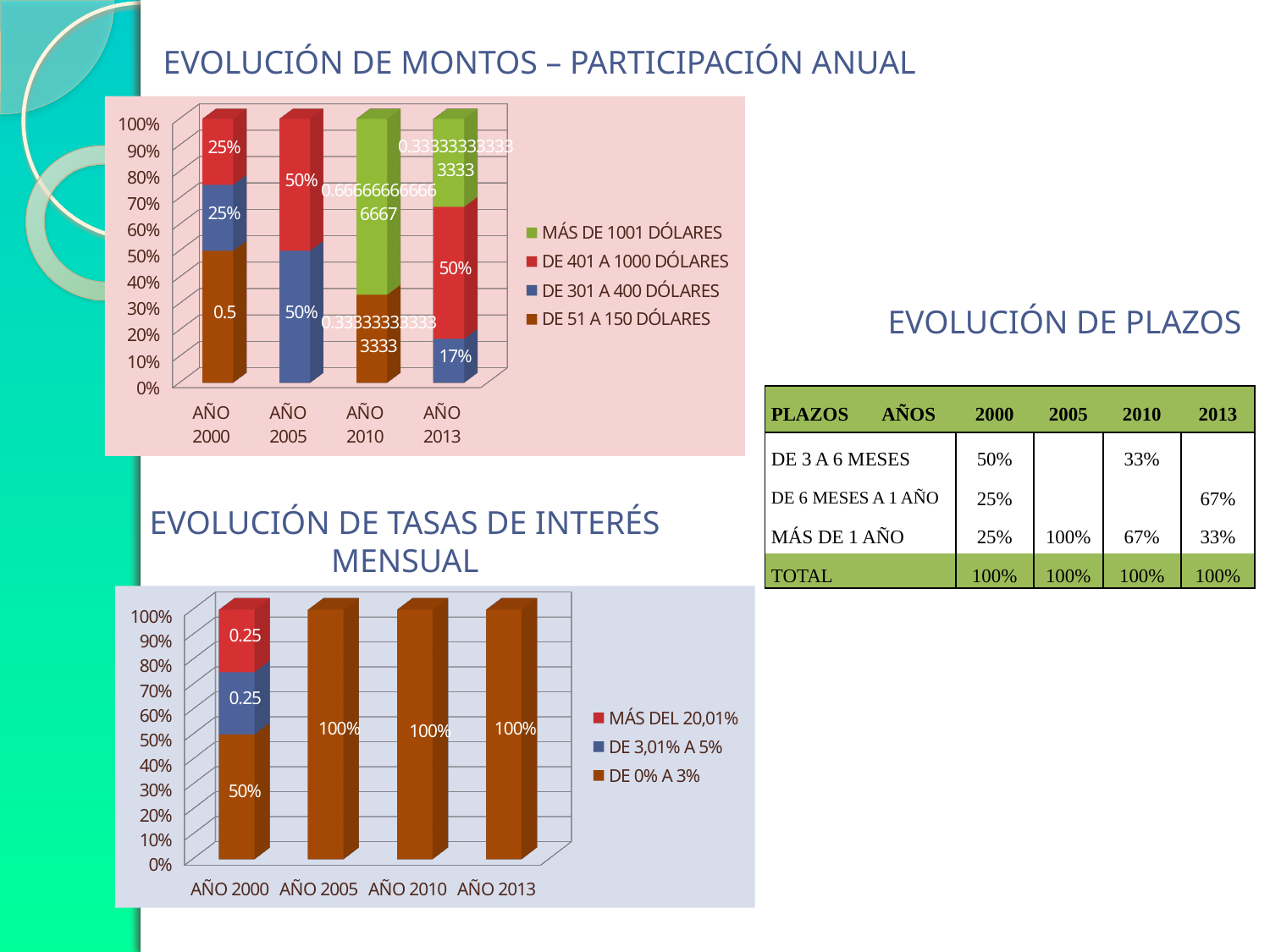
In the 'EVOLUCIÓN DE MONTOS – PARTICIPACIÓN ANUAL' chart, how many years are shown on the x axis? 4 In the 'EVOLUCIÓN DE MONTOS – PARTICIPACIÓN ANUAL' chart, what is the value for DE 301 A 400 DÓLARES in AÑO 2013? 17% In the 'EVOLUCIÓN DE MONTOS – PARTICIPACIÓN ANUAL' chart, what is the value for DE 401 A 1000 DÓLARES in AÑO 2013? 50% In the 'EVOLUCIÓN DE TASAS DE INTERÉS MENSUAL' chart, what is the value for DE 0% A 3% in AÑO 2000? 50% In the 'EVOLUCIÓN DE MONTOS – PARTICIPACIÓN ANUAL' chart, which is larger in AÑO 2013: DE 401 A 1000 DÓLARES or DE 301 A 400 DÓLARES? DE 401 A 1000 DÓLARES In the 'EVOLUCIÓN DE MONTOS – PARTICIPACIÓN ANUAL' chart, what is the value labelled on the DE 51 A 150 DÓLARES segment for AÑO 2000? 0.5 In the 'EVOLUCIÓN DE MONTOS – PARTICIPACIÓN ANUAL' chart, what is the value for DE 301 A 400 DÓLARES in AÑO 2005? 50% In the 'EVOLUCIÓN DE TASAS DE INTERÉS MENSUAL' chart, what is the value for DE 0% A 3% in AÑO 2010? 100% In the 'EVOLUCIÓN DE TASAS DE INTERÉS MENSUAL' chart, what is the difference between the DE 0% A 3% value in AÑO 2005 and in AÑO 2000? 50% In the 'EVOLUCIÓN DE TASAS DE INTERÉS MENSUAL' chart, how many series does the legend list? 3 What kind of chart is 'EVOLUCIÓN DE TASAS DE INTERÉS MENSUAL'? Stacked bar chart In the 'EVOLUCIÓN DE MONTOS – PARTICIPACIÓN ANUAL' chart, how many series does the legend list? 4